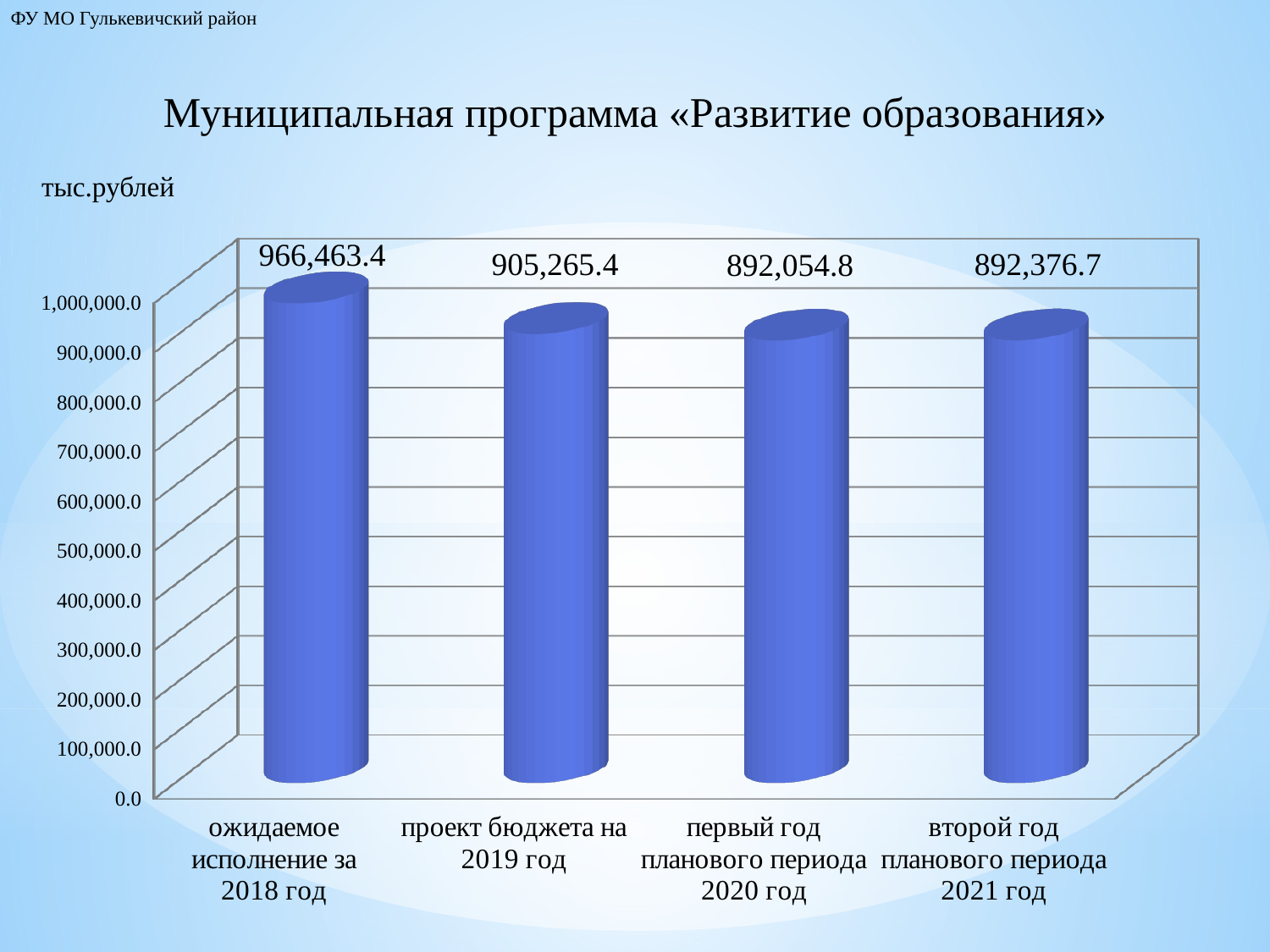
What is the difference between the 2018 value and the 2019 value? 61,198.0 Which category has the lowest value? первый год планового периода 2020 год Which category has the highest value? ожидаемое исполнение за 2018 год What kind of chart is shown on the slide? bar chart What is the value for «первый год планового периода 2020 год»? 892,054.8 Which is larger: the value for 2020 or the value for 2021? 2021 (892,376.7) How many categories are shown on the chart? 4 What is the value for «ожидаемое исполнение за 2018 год»? 966,463.4 In what units are the chart values given, according to the slide? тыс.рублей What is the value for «проект бюджета на 2019 год»? 905,265.4 What is the value for «второй год планового периода 2021 год»? 892,376.7 Is the value for «ожидаемое исполнение за 2018 год» greater or less than 900,000.0? greater